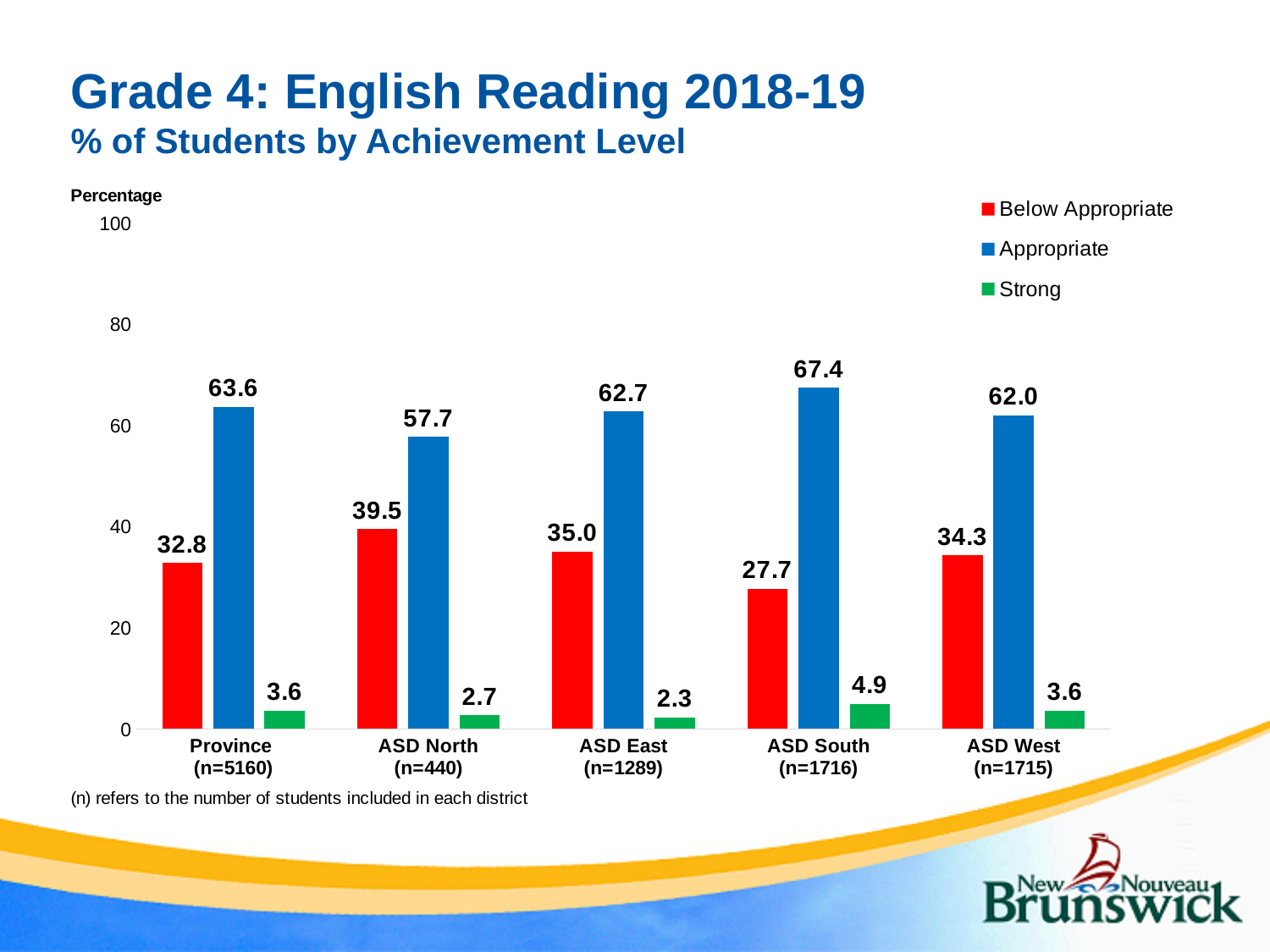
How many series does the legend list? 3 Which colour represents the Strong series in the legend? Green Which category has the lowest Strong percentage? ASD East Which category has the lowest Below Appropriate percentage? ASD South Which district has the highest Appropriate percentage? ASD South How many categories are shown on the x axis? 5 What is the Below Appropriate percentage for ASD North? 39.5 What is the Strong percentage for ASD East? 2.3 Which is larger, the Below Appropriate percentage for ASD East or for ASD West? ASD East What kind of chart is shown on the slide? Bar chart What is the difference between the Appropriate percentages for Province and ASD North? 5.9 What is the Appropriate percentage for ASD South? 67.4